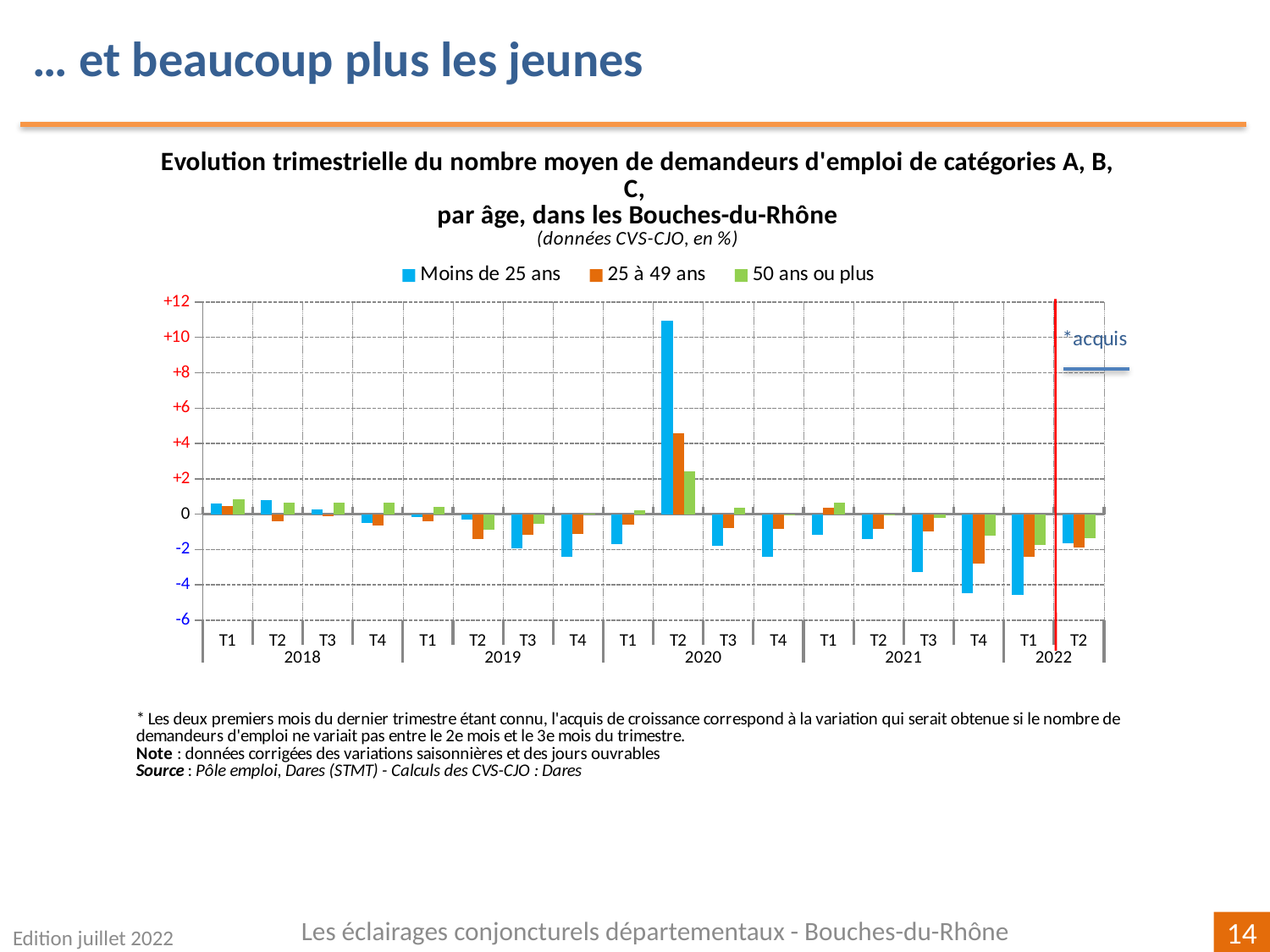
What kind of chart is shown on the slide? bar chart Is the value for 'Moins de 25 ans' in T3 2021 greater or less than -2? less Which quarter is marked as '*acquis' by the red vertical line? T2 2022 Which colour represents the 'Moins de 25 ans' series? blue How many series does the legend list? 3 How many quarters are plotted along the x axis? 18 Is the value for 'Moins de 25 ans' in T2 2020 greater or less than +8? greater Is the value for 'Moins de 25 ans' in T4 2021 greater or less than -4? less In T4 2021, which series has the lower value: 'Moins de 25 ans' or '50 ans ou plus'? Moins de 25 ans In T2 2020, which series has the larger value: 'Moins de 25 ans' or '25 à 49 ans'? Moins de 25 ans In which quarter does the 'Moins de 25 ans' series reach its highest value? T2 2020